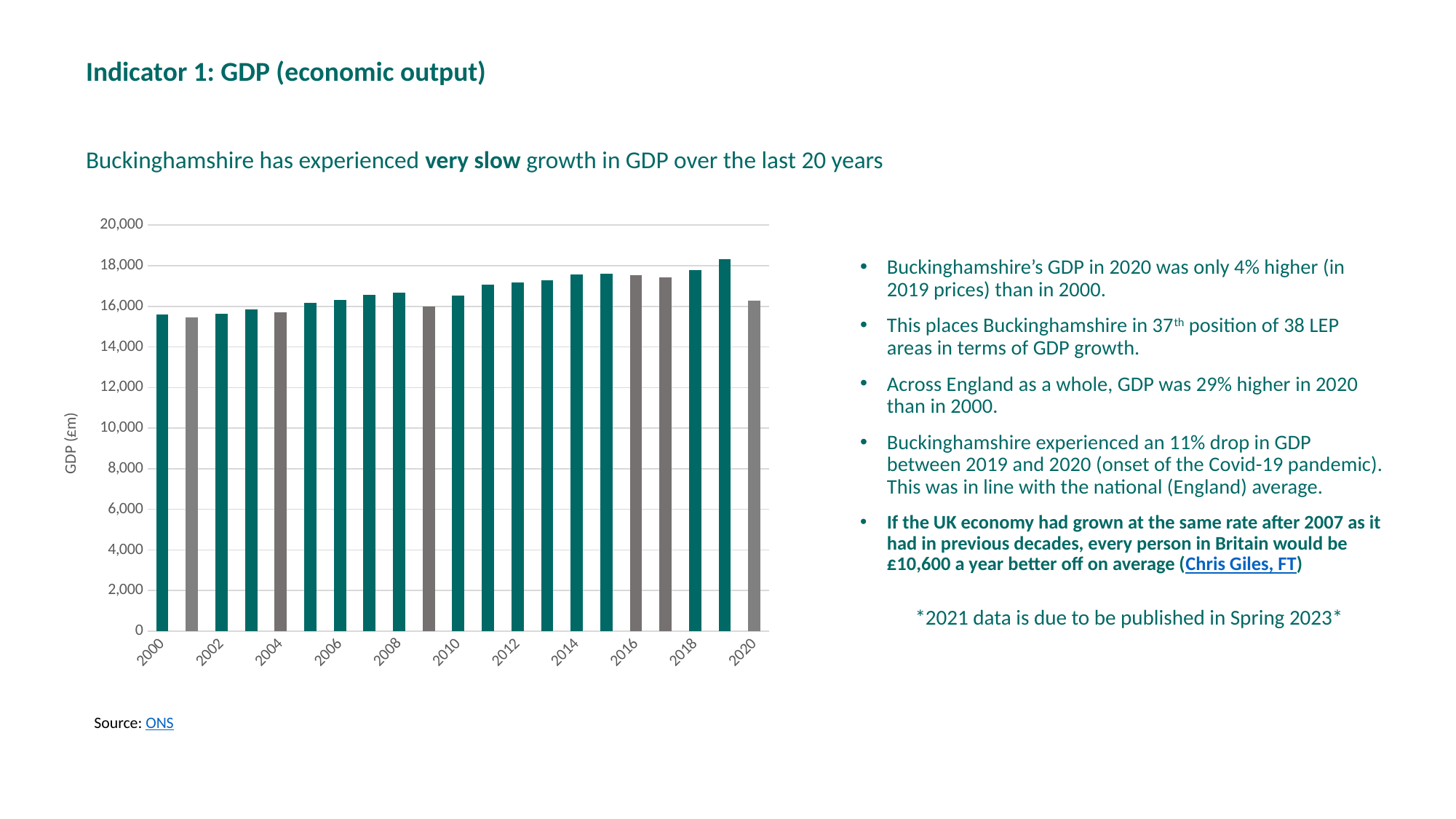
Which is larger, the value for 2019 or the value for 2020? 2019 Is the value for 2019 greater or less than 18,000? greater What kind of chart is shown on the slide? bar chart What is the label on the vertical axis of the chart? GDP (£m) Which year has the highest GDP on the chart? 2019 Is the value for 2014 greater or less than 18,000? less Which is larger, the value for 2000 or the value for 2020? 2020 How many years (bars) are plotted on the chart? 21 Overall, do the values rise or fall from 2000 to 2019? rise Is the value for 2020 greater or less than 16,000? greater Which is larger, the value for 2008 or the value for 2009? 2008